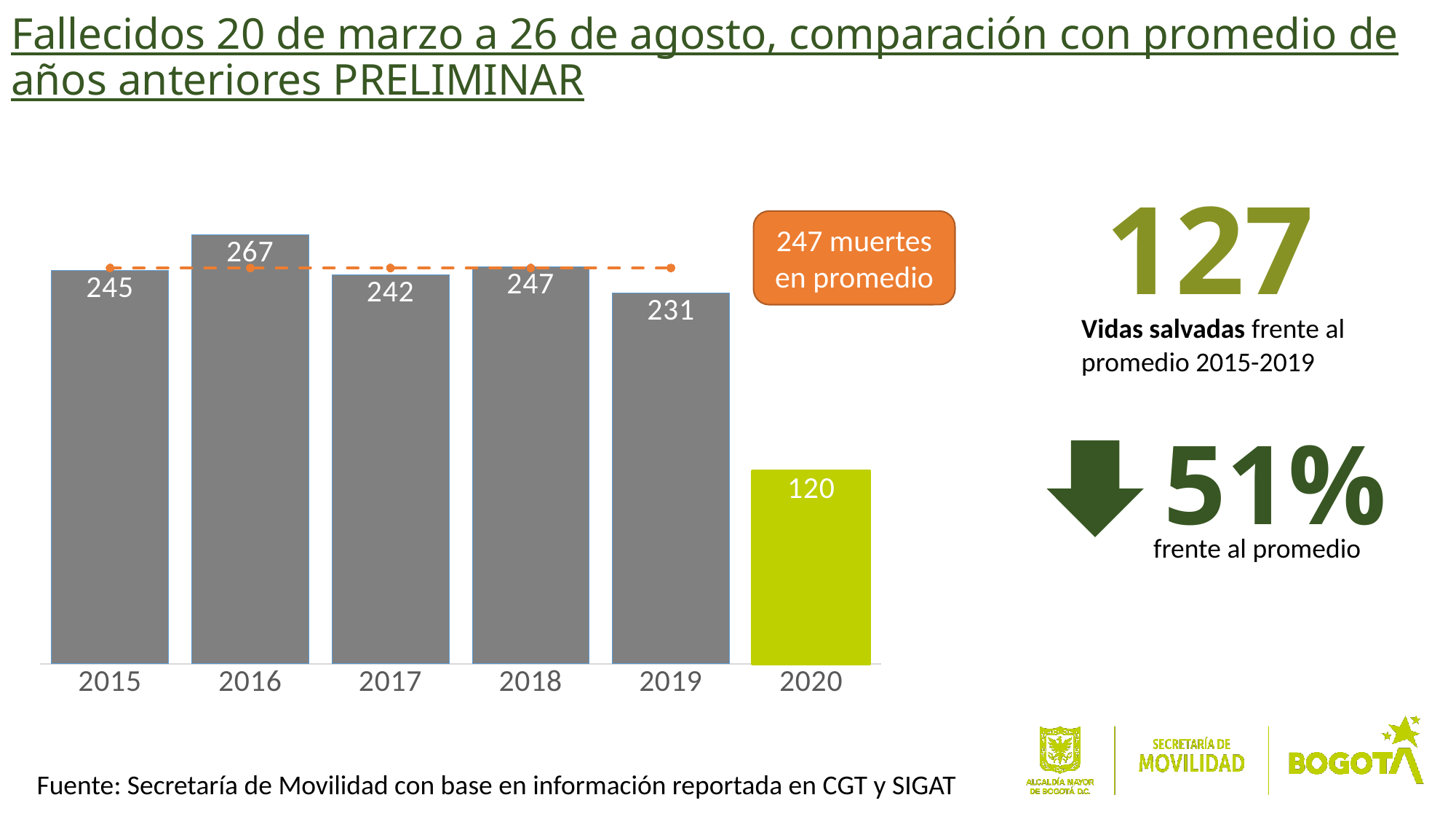
Which year has the highest value? 2016 How many years are shown on the x axis? 6 Which bar is shown in a different colour (green) from the others? 2020 What kind of chart is this? bar chart What is the value for 2019? 231 What is the difference between the values for 2018 and 2019? 16 What is the value for 2020? 120 Which year has the lowest value? 2020 What average value does the dashed line represent, according to the orange label? 247 muertes en promedio Which is larger, the value for 2015 or the value for 2017? 2015 What is the value for 2016? 267 What is the difference between the values for 2016 and 2020? 147